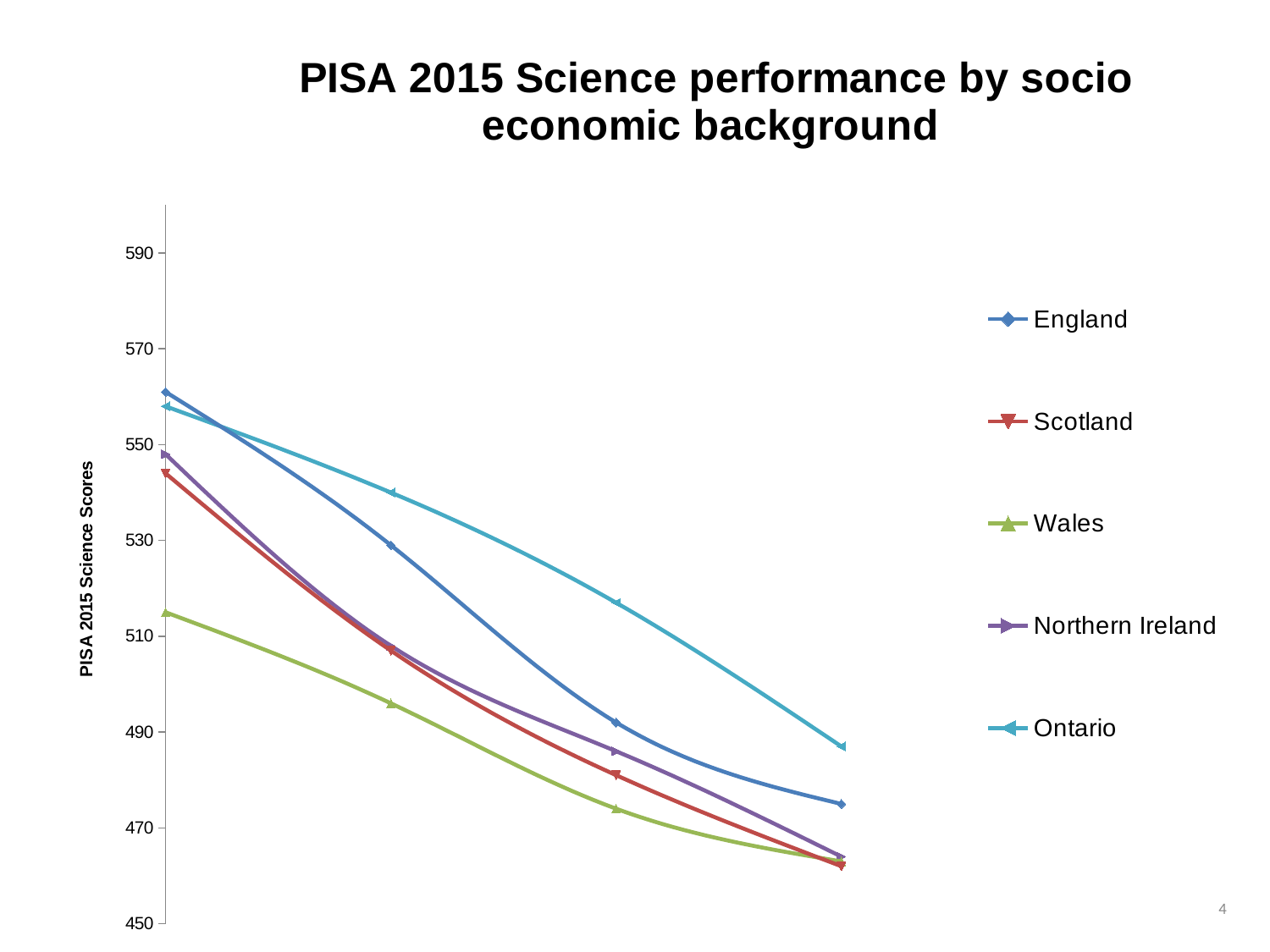
Is the value for England at the leftmost point greater or less than 550? greater Do the lines rise or fall from left to right? fall What is the title of the chart? PISA 2015 Science performance by socio economic background At the rightmost point, which is higher, Ontario or England? Ontario Is the value for Scotland at the rightmost point greater or less than 470? less What kind of chart is shown on the slide? line chart Which series has the lowest value at the leftmost point? Wales How many series does the legend list? 5 Which series has the highest value at the second point from the left? Ontario Which series has the highest value at the rightmost point? Ontario How many data points does each line have? 4 At the leftmost point, which is higher, England or Wales? England